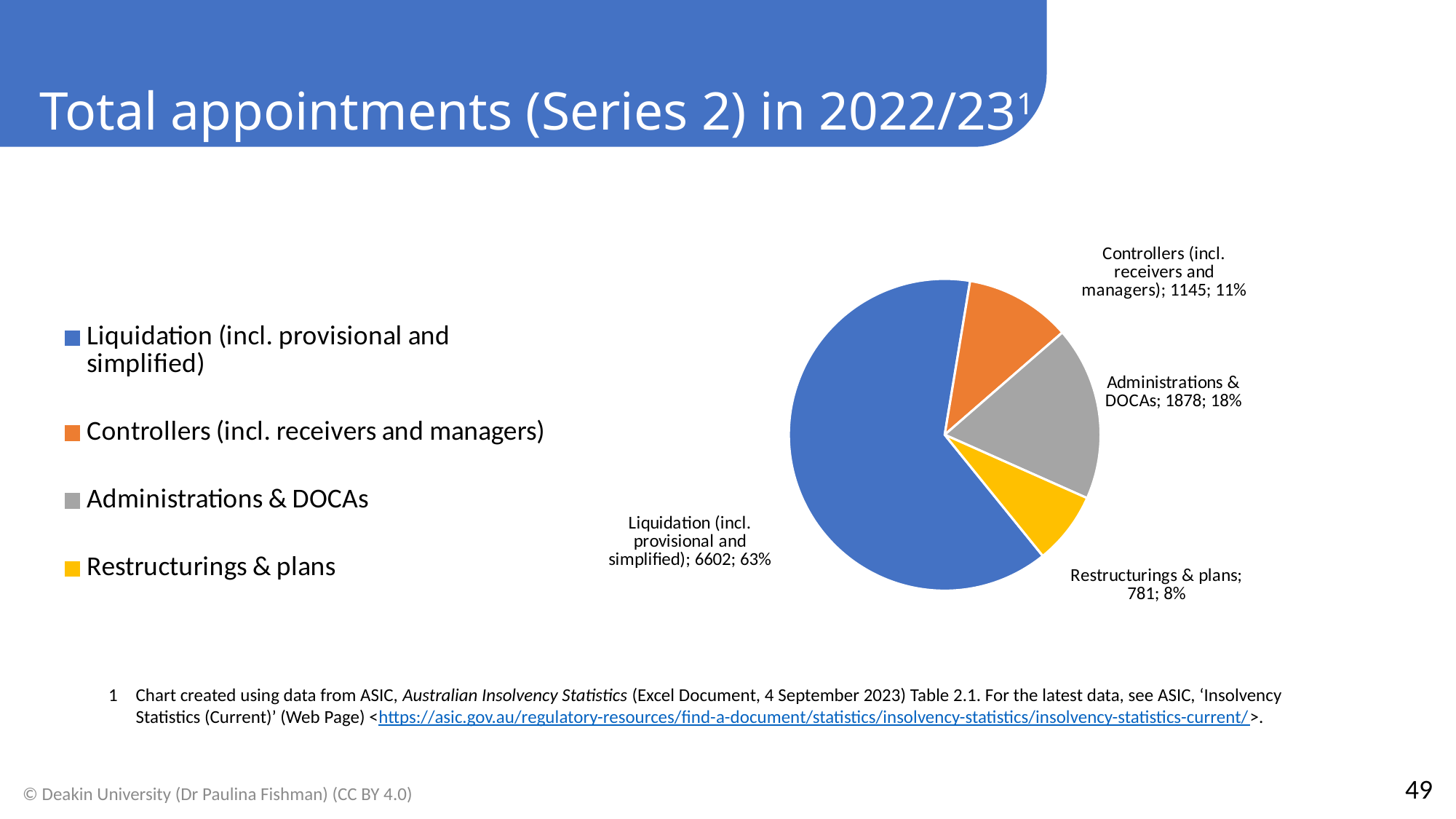
Which category has the smallest slice? Restructurings & plans Which category has the largest slice? Liquidation (incl. provisional and simplified) What share of the pie does Restructurings & plans represent? 8% What is the value for Restructurings & plans? 781 What kind of chart is shown on the slide? pie chart What is the value for Controllers (incl. receivers and managers)? 1145 What share of the pie does Liquidation (incl. provisional and simplified) represent? 63% Which colour represents Administrations & DOCAs in the legend? grey What is the value for Administrations & DOCAs? 1878 How many slices does the pie chart have? 4 What is the difference between the values for Administrations & DOCAs and Controllers (incl. receivers and managers)? 733 What is the value for Liquidation (incl. provisional and simplified)? 6602